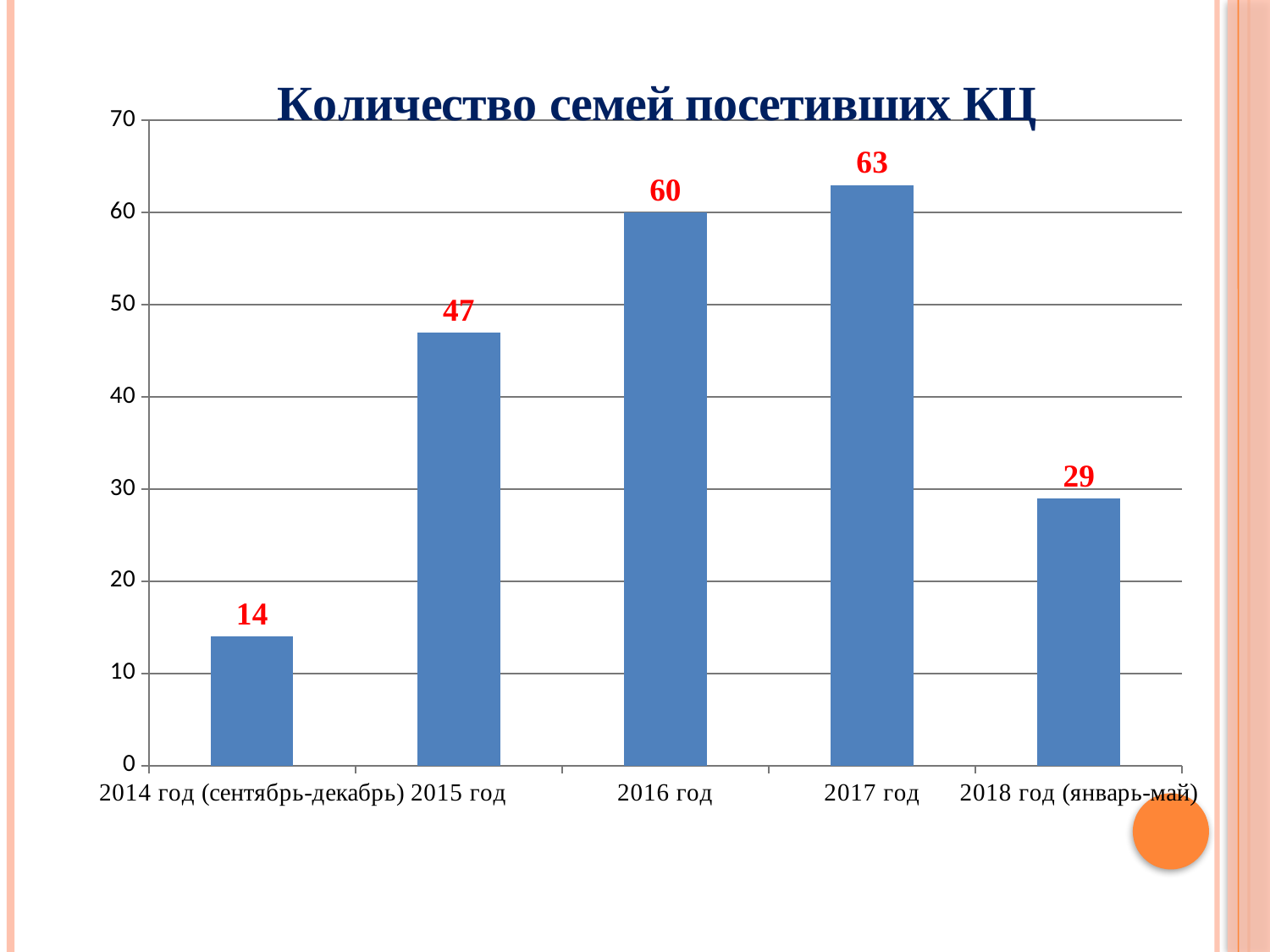
Which is larger, the value for 2015 год or the value for 2018 год (январь-май)? 2015 год How many categories are shown on the x axis? 5 What is the title of the chart? Количество семей посетивших КЦ What is the value for 2014 год (сентябрь-декабрь)? 14 Which category has the lowest value? 2014 год (сентябрь-декабрь) What is the value for 2018 год (январь-май)? 29 What kind of chart is shown on the slide? bar chart What is the difference between the values for 2017 год and 2015 год? 16 Which category has the highest value? 2017 год Is the value for 2015 год greater or less than 50? less Do the values rise or fall from 2014 год (сентябрь-декабрь) to 2017 год? rise What is the value for 2016 год? 60